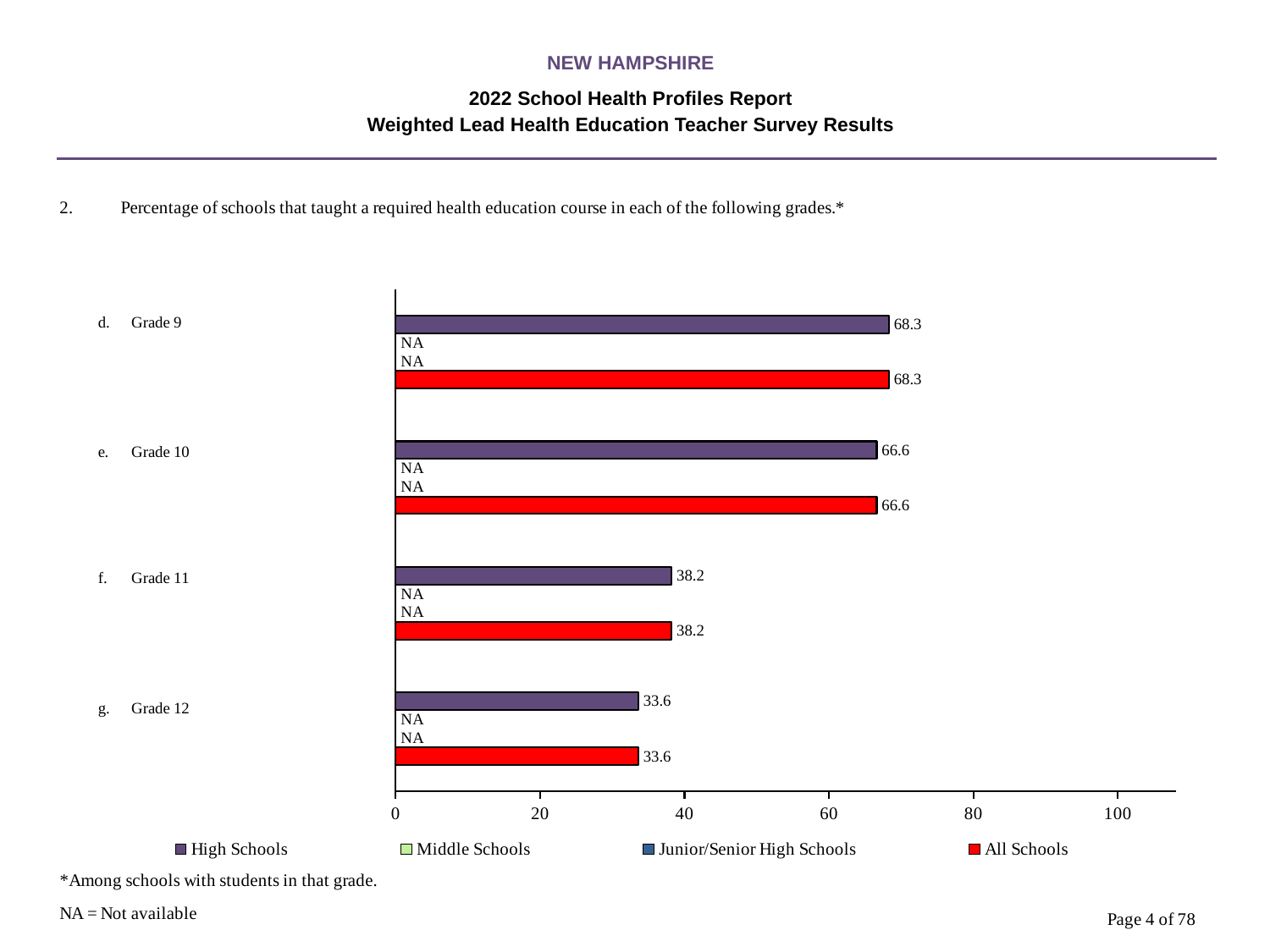
What is the difference between the High Schools values for Grade 10 and Grade 11? 28.4 What is the value for All Schools in Grade 11? 38.2 Do the High Schools values rise or fall from Grade 9 to Grade 12? Fall What is the value for High Schools in Grade 12? 33.6 What is the value for High Schools in Grade 9? 68.3 What is the value for All Schools in Grade 10? 66.6 Which is larger for High Schools: Grade 9 or Grade 12? Grade 9 Which grade has the lowest value for All Schools? Grade 12 What is shown for Middle Schools in Grade 9? NA How many series does the legend list? 4 What kind of chart is shown on the slide? Bar chart Which grade has the highest value for High Schools? Grade 9